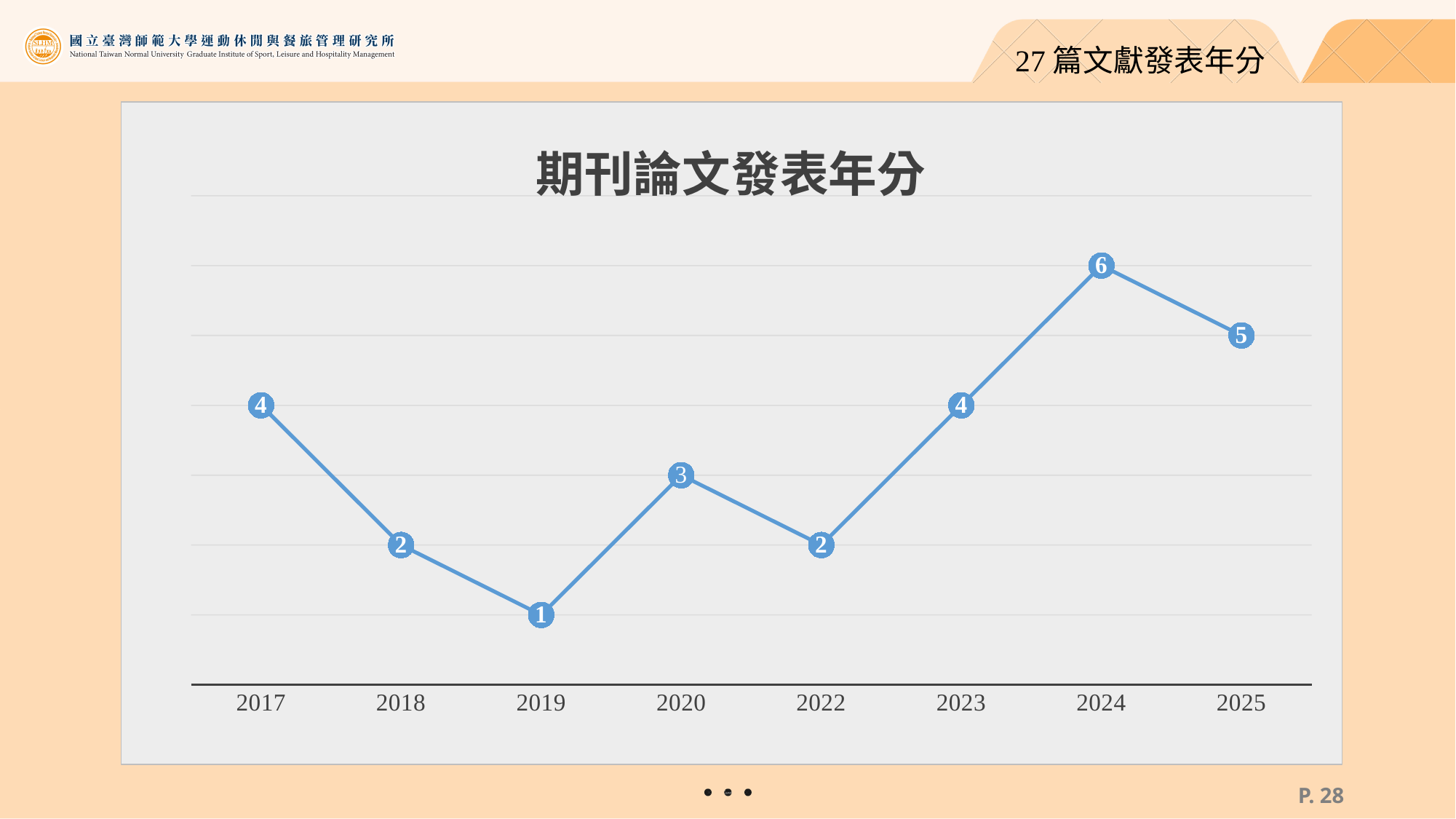
What is the title of the chart? 期刊論文發表年分 What kind of chart is this? line chart What is the difference between the values for 2024 and 2019? 5 What is the value for 2025? 5 Which is larger, the value for 2020 or the value for 2022? 2020 Which year has the lowest value? 2019 What is the value for 2017? 4 What is the value for 2019? 1 What is the value for 2024? 6 Which year has the highest value? 2024 Do the values rise or fall from 2022 to 2024? rise How many years are shown on the x axis? 8